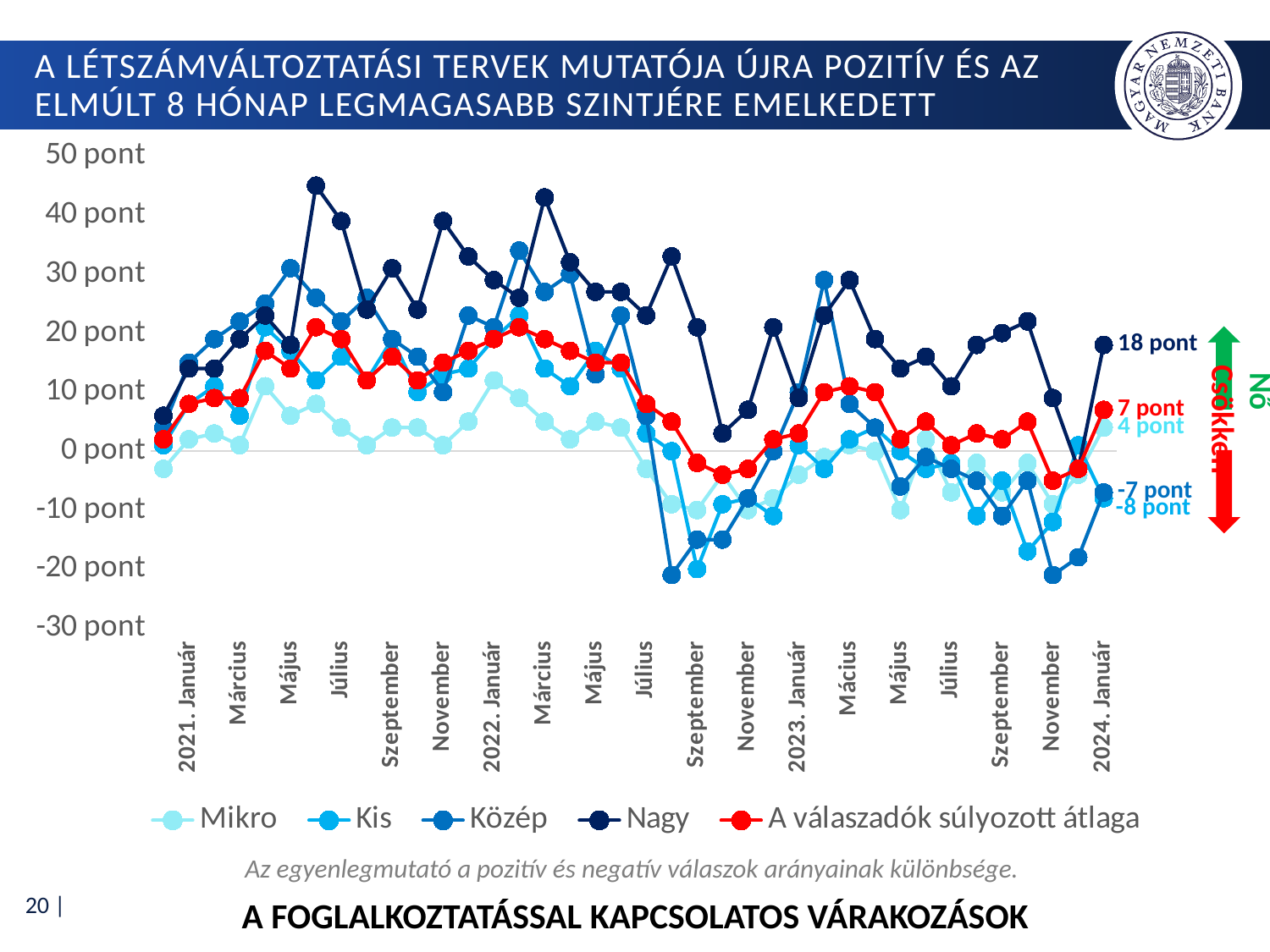
What kind of chart is shown on the slide? line chart Is the value of the Kis series at 2022. Szeptember greater or less than -10 pont? less What is the value of the Nagy series at 2024. Január? 18 pont Which series is drawn in red? A válaszadók súlyozott átlaga How many series does the legend list? 5 At 2024. Január, which is larger: the Nagy value or the Mikro value? Nagy Does 'A válaszadók súlyozott átlaga' rise or fall between 2021. Január and 2021. Július? rises At 2024. Január, how much higher is the Nagy series than 'A válaszadók súlyozott átlaga'? 11 pont What is the value of the Mikro series at 2024. Január? 4 pont Is the value of the Nagy series at 2022. Március greater or less than 30 pont? greater Which series has the highest value at 2024. Január? Nagy What is the value of 'A válaszadók súlyozott átlaga' at 2024. Január? 7 pont